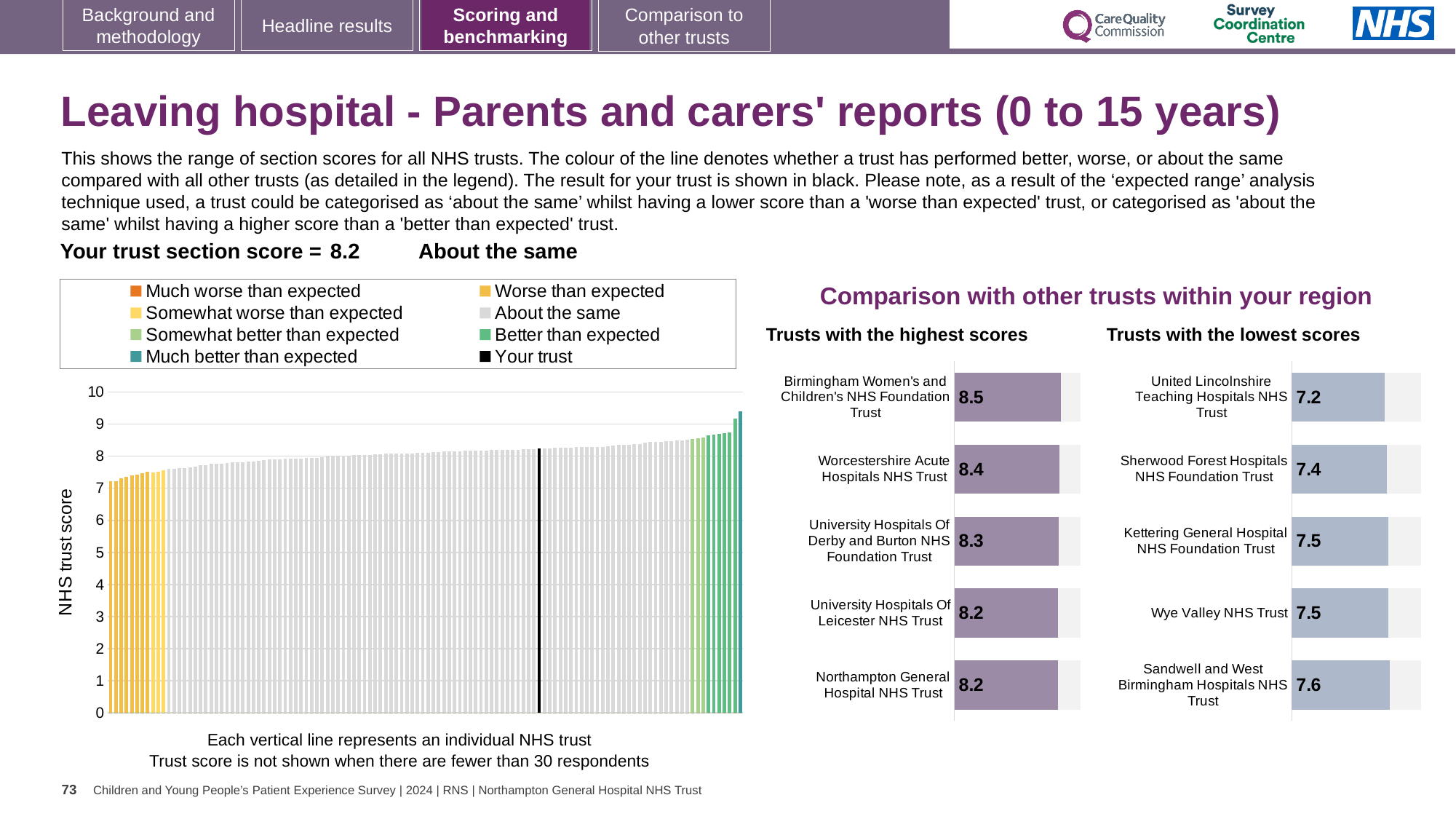
In the 'Trusts with the lowest scores' chart, what is the score for United Lincolnshire Teaching Hospitals NHS Trust? 7.2 What kind of chart is the main 'NHS trust score' chart? bar chart In the 'Trusts with the lowest scores' chart, which trust has the lowest score? United Lincolnshire Teaching Hospitals NHS Trust In the 'Trusts with the lowest scores' chart, which has the higher score: Sherwood Forest Hospitals NHS Foundation Trust or Sandwell and West Birmingham Hospitals NHS Trust? Sandwell and West Birmingham Hospitals NHS Trust In the main 'NHS trust score' chart, is the value of the rightmost (highest) bar greater or less than 9? greater In the 'Trusts with the highest scores' chart, what is the difference between the scores of Birmingham Women's and Children's NHS Foundation Trust and Northampton General Hospital NHS Trust? 0.3 In the 'Trusts with the highest scores' chart, which trust has the highest score? Birmingham Women's and Children's NHS Foundation Trust How many trusts are shown in the 'Trusts with the highest scores' chart? 5 In the main 'NHS trust score' chart, do the values rise or fall from left to right along the x axis? rise In the 'Trusts with the lowest scores' chart, what is the difference between the scores of Sandwell and West Birmingham Hospitals NHS Trust and United Lincolnshire Teaching Hospitals NHS Trust? 0.4 In the 'Trusts with the highest scores' chart, what is the score for Birmingham Women's and Children's NHS Foundation Trust? 8.5 How many entries does the legend of the main 'NHS trust score' chart list? 8